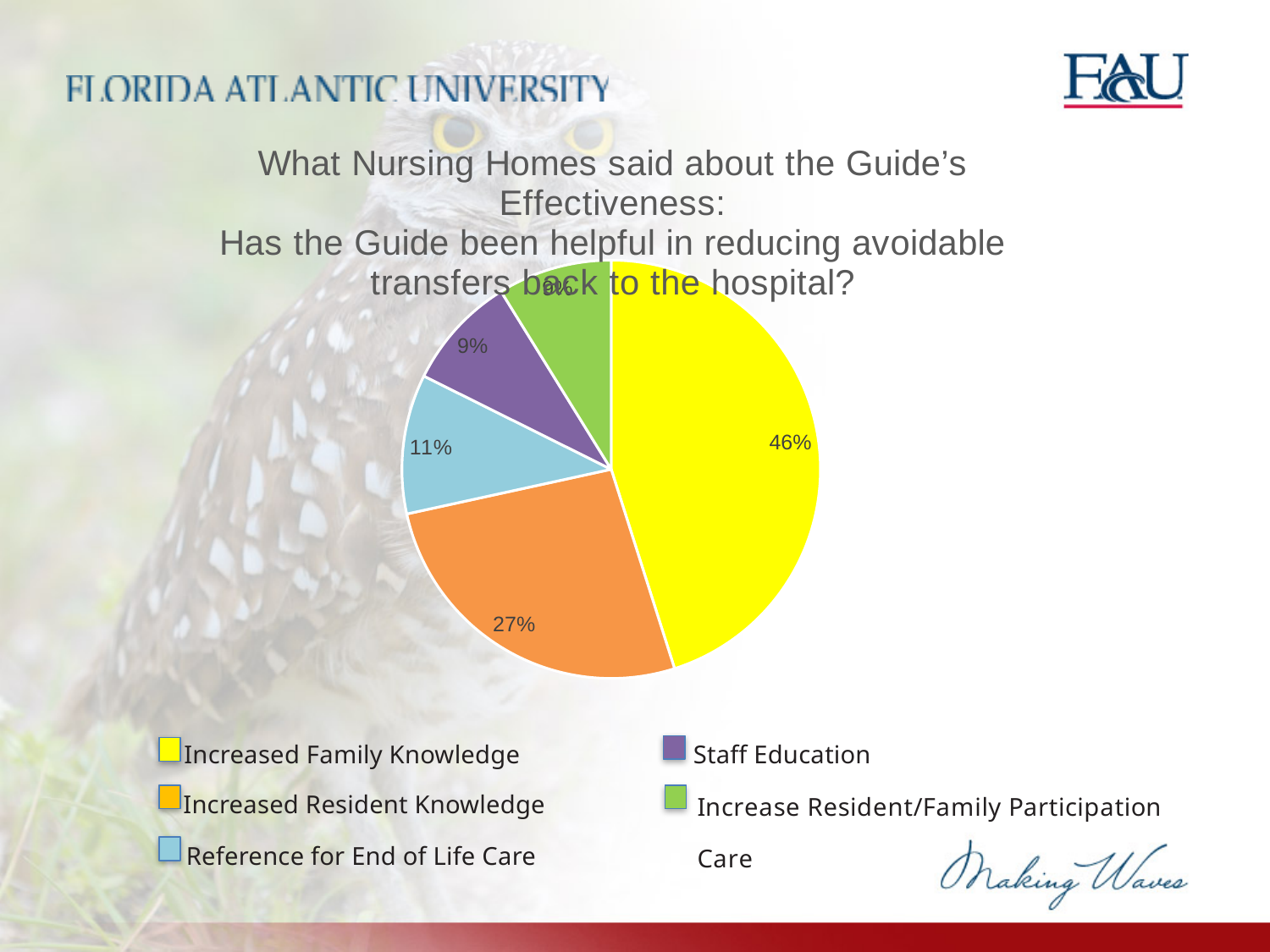
What percentage of the pie is labelled for Staff Education? 9% What colour is the slice for Staff Education? purple What percentage of the pie is labelled for Reference for End of Life Care? 11% Which category has the largest slice of the pie? Increased Family Knowledge What colour is the slice for Increased Family Knowledge? yellow What is the difference in percentage points between Increased Family Knowledge and Increased Resident Knowledge? 19 How many categories does the legend list? 5 What percentage of the pie is labelled for Increased Family Knowledge? 46% Which is larger, the slice for Reference for End of Life Care or the slice for Staff Education? Reference for End of Life Care What percentage of the pie is labelled for Increased Resident Knowledge? 27% What type of chart is shown on the slide? pie chart